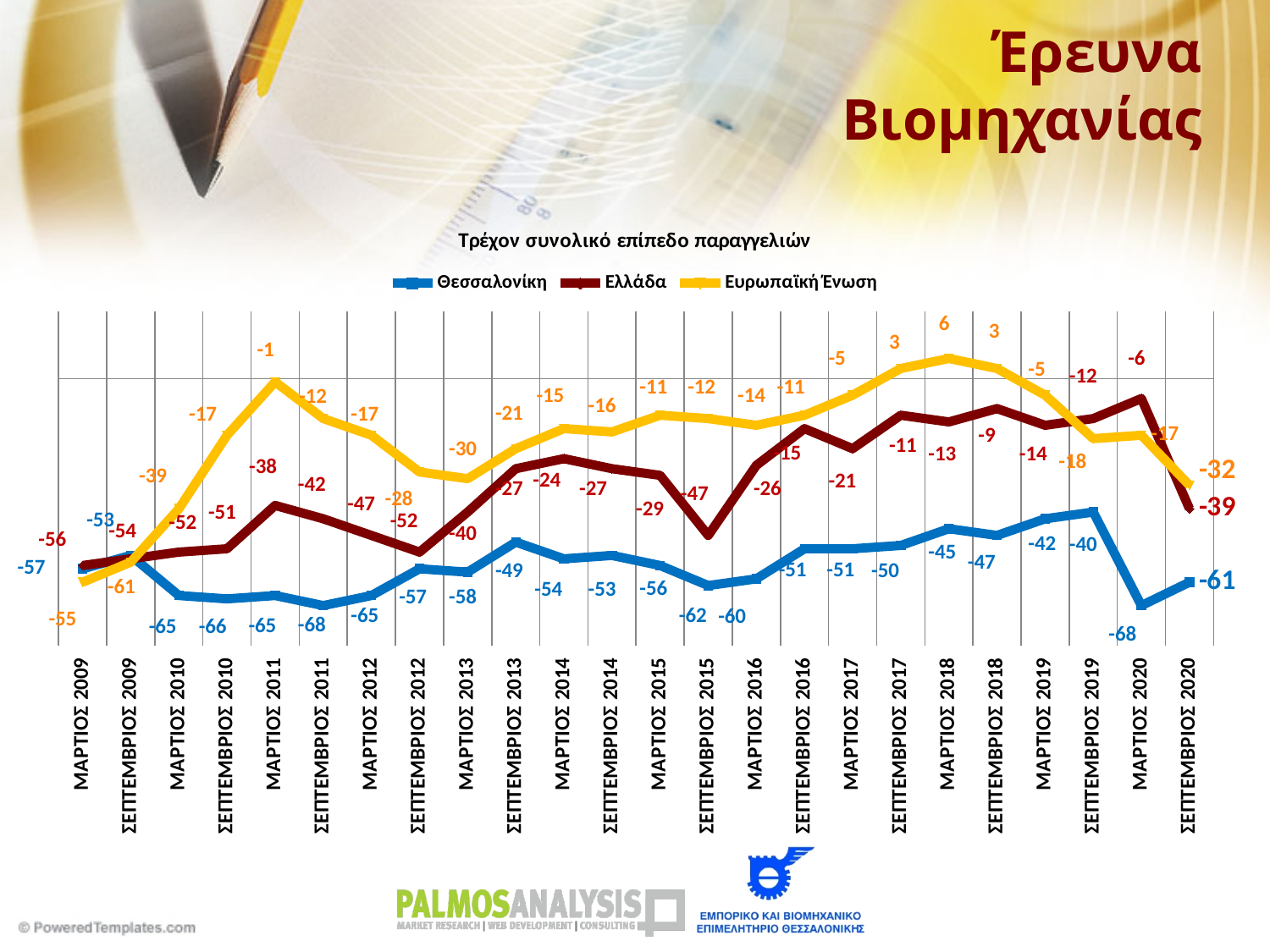
What is the value for Ελλάδα in ΜΑΡΤΙΟΣ 2020? -6 In which period does the Ελλάδα series have its lowest value? ΜΑΡΤΙΟΣ 2009 In which period does the Ευρωπαϊκή Ένωση series reach its highest value? ΜΑΡΤΙΟΣ 2018 How many time points are plotted along the x axis? 24 How many series does the legend list? 3 What kind of chart is shown on the slide? line chart What is the title of the chart? Τρέχον συνολικό επίπεδο παραγγελιών What is the value for Ευρωπαϊκή Ένωση in ΜΑΡΤΙΟΣ 2018? 6 In ΜΑΡΤΙΟΣ 2011, which is larger: the value for Ελλάδα or for Ευρωπαϊκή Ένωση? Ευρωπαϊκή Ένωση What is the value for Θεσσαλονίκη in ΣΕΠΤΕΜΒΡΙΟΣ 2020? -61 What is the difference between the Ελλάδα and Θεσσαλονίκη values in ΣΕΠΤΕΜΒΡΙΟΣ 2020? 22 What is the value for Θεσσαλονίκη in ΜΑΡΤΙΟΣ 2011? -65